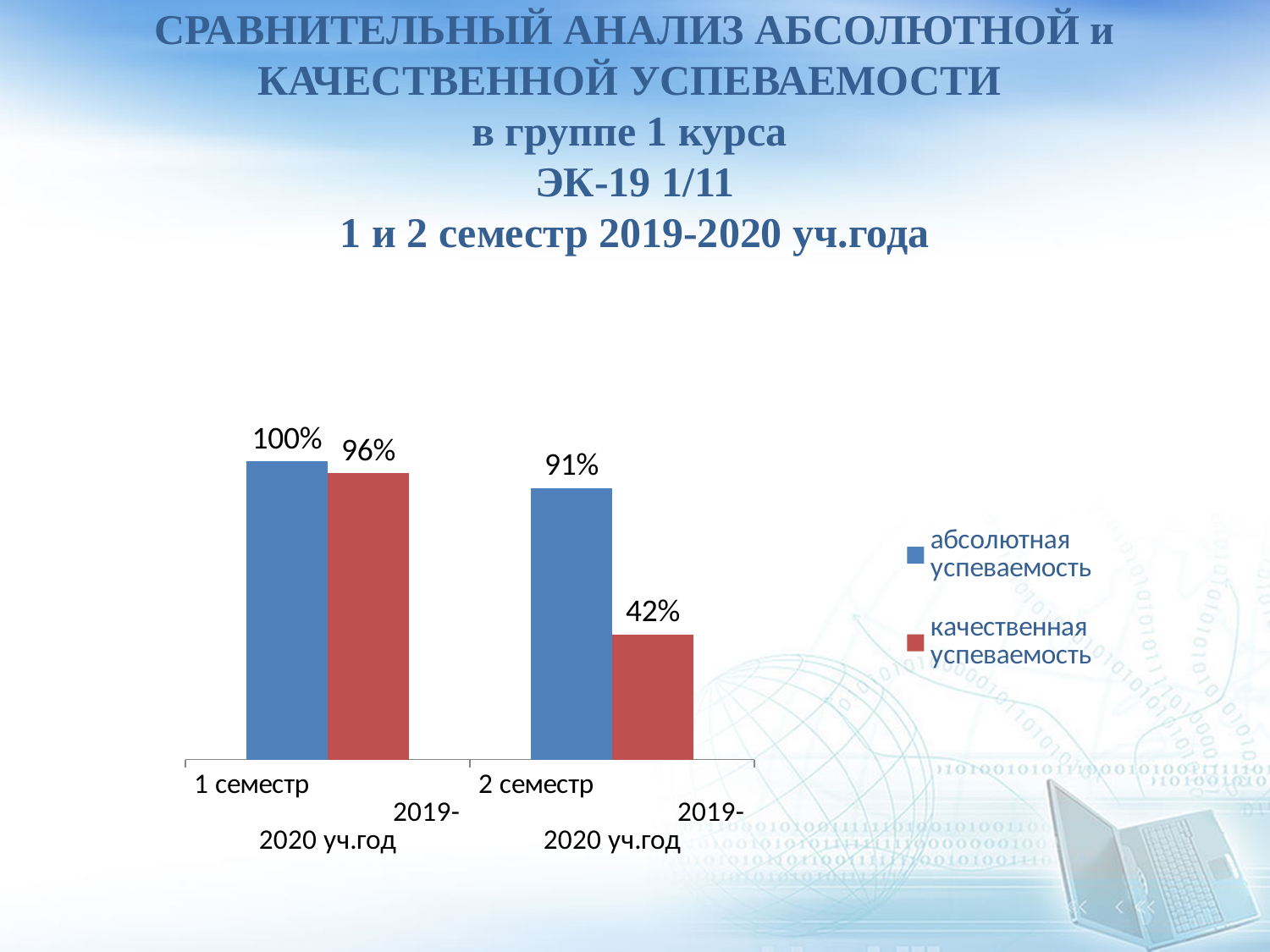
What is the value of качественная успеваемость for 2 семестр 2019-2020 уч.год? 42% How many categories are shown on the x axis? 2 What is the value of абсолютная успеваемость for 2 семестр 2019-2020 уч.год? 91% Which semester has the lowest качественная успеваемость? 2 семестр 2019-2020 уч.год What kind of chart is shown on the slide? bar chart What is the value of абсолютная успеваемость for 1 семестр 2019-2020 уч.год? 100% What is the value of качественная успеваемость for 1 семестр 2019-2020 уч.год? 96% Which is larger: абсолютная успеваемость in 2 семестр or качественная успеваемость in 2 семестр? абсолютная успеваемость in 2 семестр How many series does the legend list? 2 What is the difference between абсолютная успеваемость in 1 семестр and 2 семестр? 9% Does качественная успеваемость rise or fall from 1 семестр to 2 семестр? fall What is the difference between качественная успеваемость in 1 семестр and 2 семестр? 54%